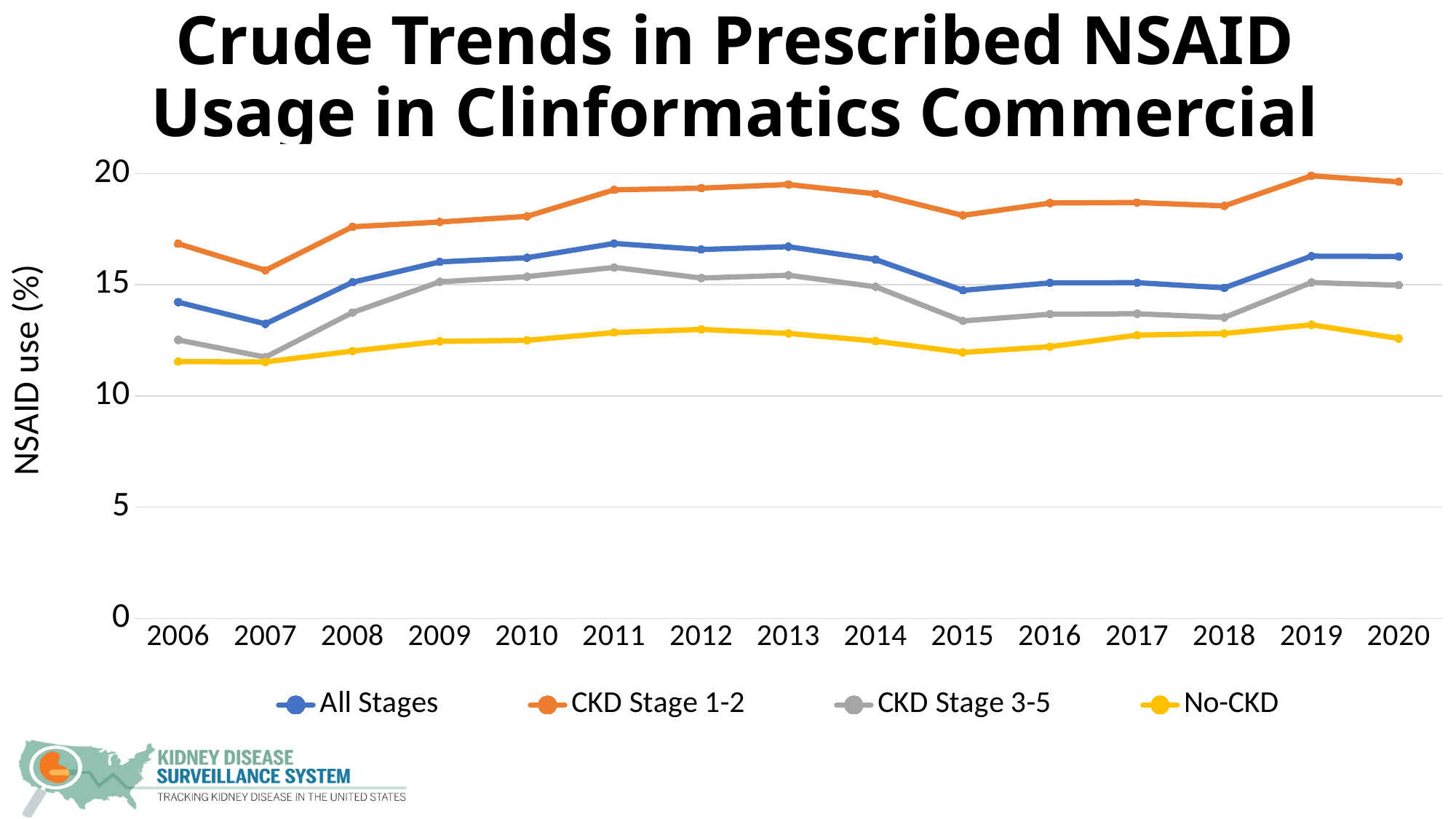
Which series has the lowest NSAID use across all years? No-CKD Is the value for No-CKD in 2007 greater or less than 15? less Is the value for CKD Stage 3-5 in 2015 greater or less than 15? less How many years are shown on the x axis? 15 What is the label on the y axis? NSAID use (%) For the All Stages series, which year has the larger value, 2006 or 2007? 2006 Is the value for CKD Stage 1-2 in 2006 greater or less than 15? greater Does the No-CKD series rise or fall from 2007 to 2013? Rises What kind of chart is shown on the slide? Line chart Which series has the highest NSAID use across all years? CKD Stage 1-2 How many series does the legend list? 4